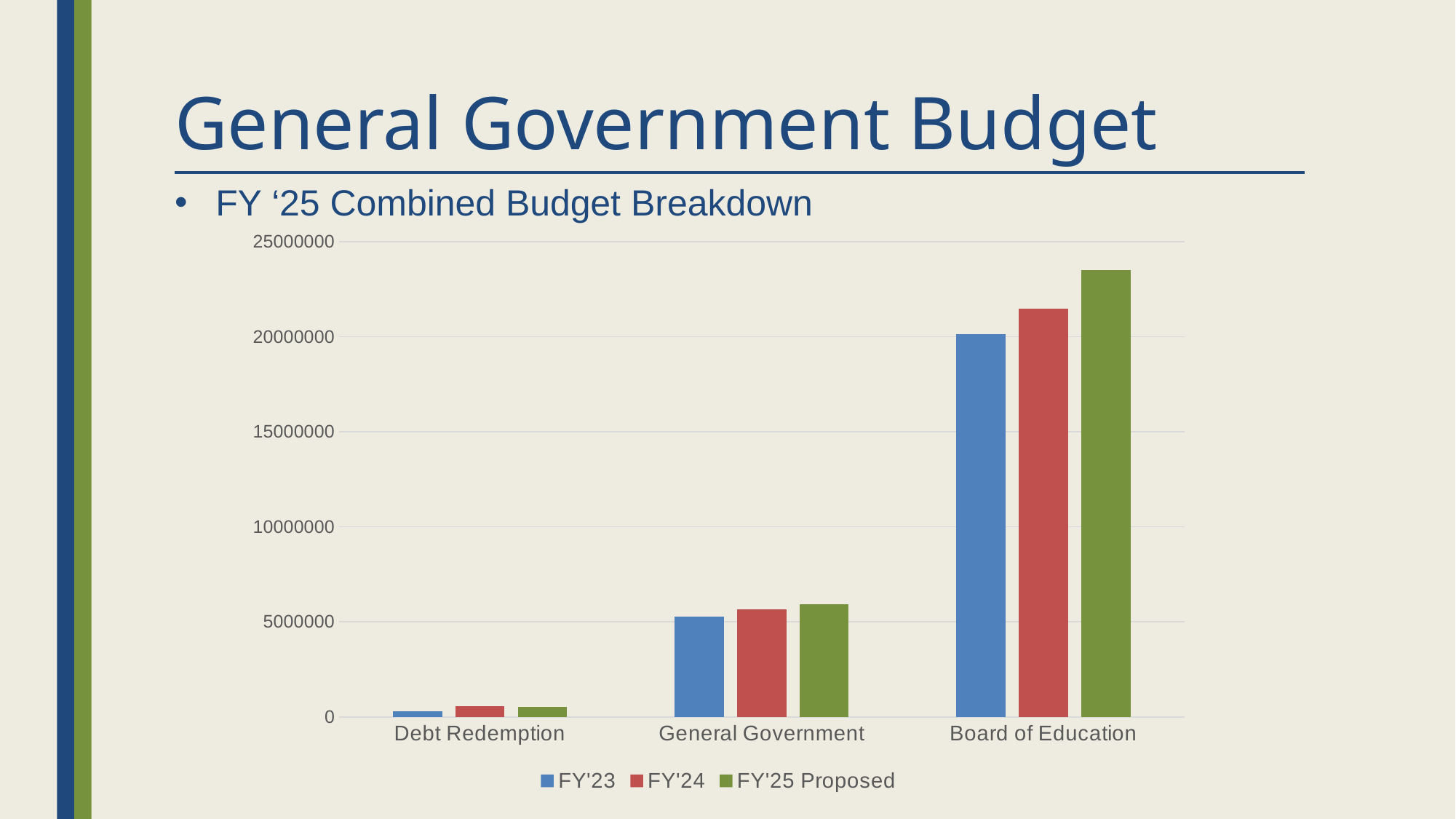
What kind of chart is shown on the slide? bar chart How many categories are shown on the x axis of the chart? 3 Is the FY'23 value for General Government greater or less than 10000000? less Is the FY'25 Proposed value for General Government greater or less than 5000000? greater Which category has the highest values in the chart? Board of Education How many series does the chart's legend list? 3 Is the FY'25 Proposed value for Board of Education greater or less than 20000000? greater For Board of Education, which is larger: the FY'23 value or the FY'25 Proposed value? FY'25 Proposed Which category has the lowest values in the chart? Debt Redemption Do the values rise or fall moving from Debt Redemption to Board of Education along the x axis? rise What are the three series listed in the chart's legend? FY'23, FY'24, FY'25 Proposed